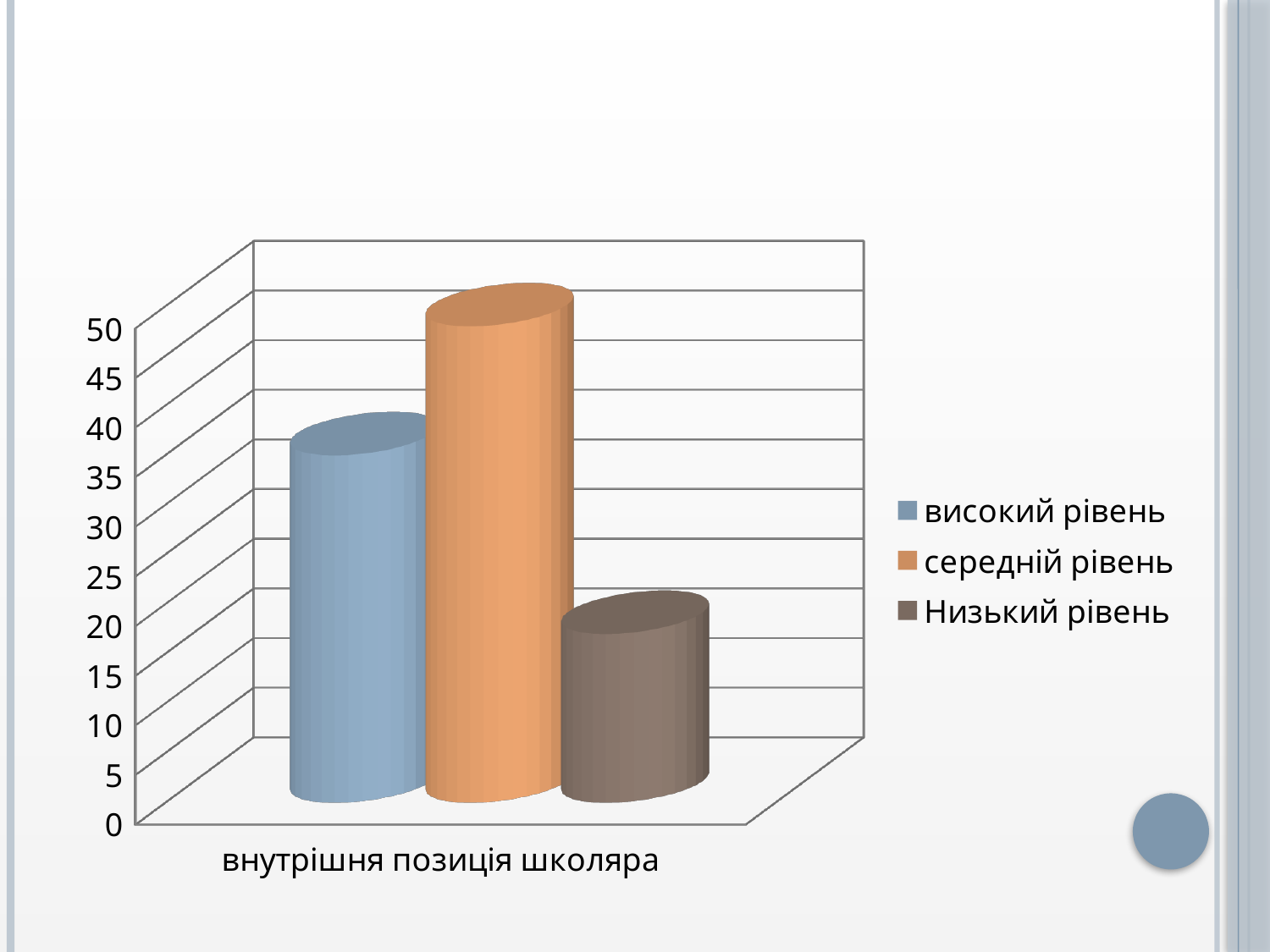
Which series has the highest value? середній рівень How many series does the legend list? 3 What is the category label shown on the x axis? внутрішня позиція школяра Which is larger, the value for середній рівень or the value for високий рівень? середній рівень What kind of chart is shown on the slide? bar chart Is the value for високий рівень greater or less than 30? greater What colour is the bar for середній рівень? orange Is the value for Низький рівень greater or less than 25? less Is the value for середній рівень greater or less than 45? greater Which series has the lowest value? Низький рівень Which is larger, the value for високий рівень or the value for Низький рівень? високий рівень How many categories are shown on the x axis? 1